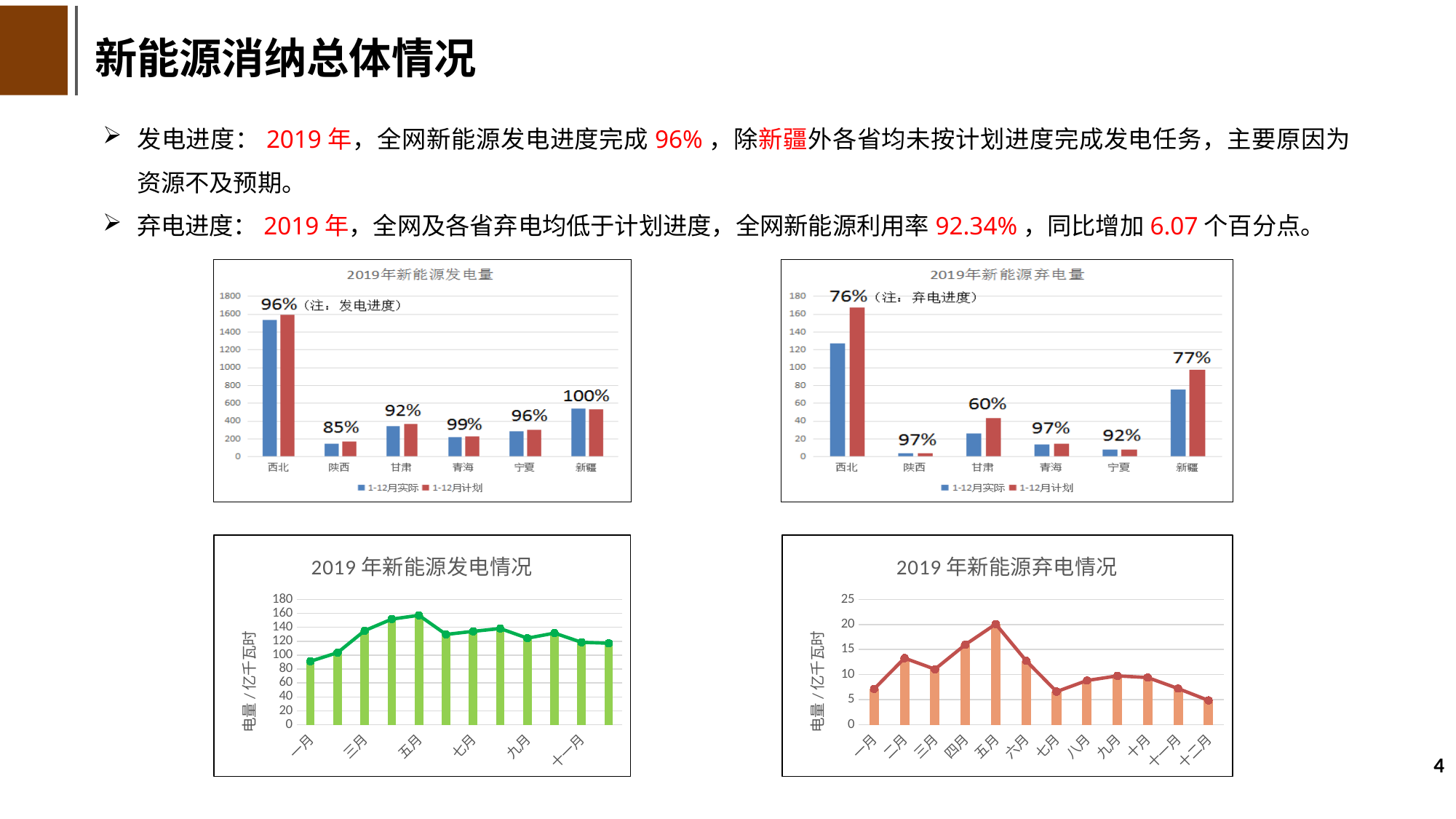
In the bottom-right chart titled 2019 年新能源弃电情况, which month has the lowest value? 十二月 How many provinces/regions are shown on the x axis of the top-left chart titled 2019年新能源发电量? 6 In the top-right chart titled 2019年新能源弃电量, which has the larger 1-12月计划 value, 西北 or 新疆? 西北 In the bottom-right chart titled 2019 年新能源弃电情况, which month has the highest value? 五月 In the top-right chart titled 2019年新能源弃电量, which province has the lowest percentage label? 甘肃 In the top-left chart titled 2019年新能源发电量, what percentage label is shown above 新疆? 100% In the top-left chart titled 2019年新能源发电量, is the 1-12月实际 value for 西北 greater or less than 1400? greater What are the two legend entries in the top-left chart titled 2019年新能源发电量? 1-12月实际 and 1-12月计划 In the top-right chart titled 2019年新能源弃电量, is the 1-12月计划 value for 西北 greater or less than 160? greater In the top-left chart titled 2019年新能源发电量, which province has the tallest bars? 西北 How many series does the legend of the top-right chart titled 2019年新能源弃电量 list? 2 In the top-right chart titled 2019年新能源弃电量, what percentage label is shown above 甘肃? 60%